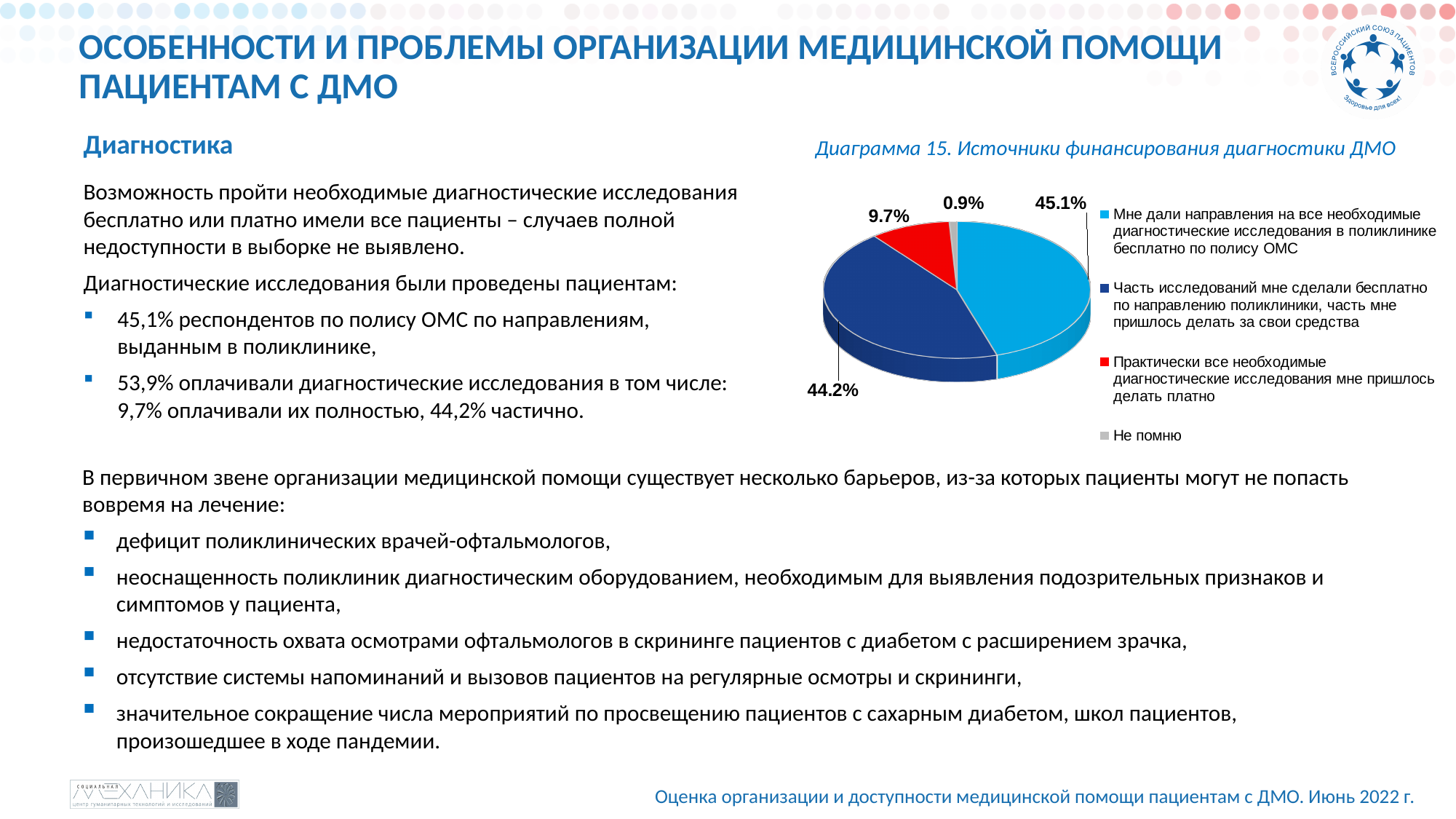
What is the title of the chart on the slide? Диаграмма 15. Источники финансирования диагностики ДМО What share of the pie corresponds to "Практически все необходимые диагностические исследования мне пришлось делать платно"? 9.7% What colour is the slice for "Практически все необходимые диагностические исследования мне пришлось делать платно"? Red Which category has the smallest share of the pie? Не помню Which category has the largest share of the pie? Мне дали направления на все необходимые диагностические исследования в поликлинике бесплатно по полису ОМС Which is larger: the share for "Практически все необходимые диагностические исследования мне пришлось делать платно" or the share for "Не помню"? Практически все необходимые диагностические исследования мне пришлось делать платно What type of chart is shown on the slide? Pie chart What is the difference in percentage points between the "Практически все необходимые диагностические исследования мне пришлось делать платно" slice and the "Не помню" slice? 8.8 What share of the pie corresponds to "Часть исследований мне сделали бесплатно по направлению поликлиники, часть мне пришлось делать за свои средства"? 44.2% What share of the pie corresponds to "Мне дали направления на все необходимые диагностические исследования в поликлинике бесплатно по полису ОМС"? 45.1% How many categories does the pie chart legend list? 4 What share of the pie corresponds to "Не помню"? 0.9%